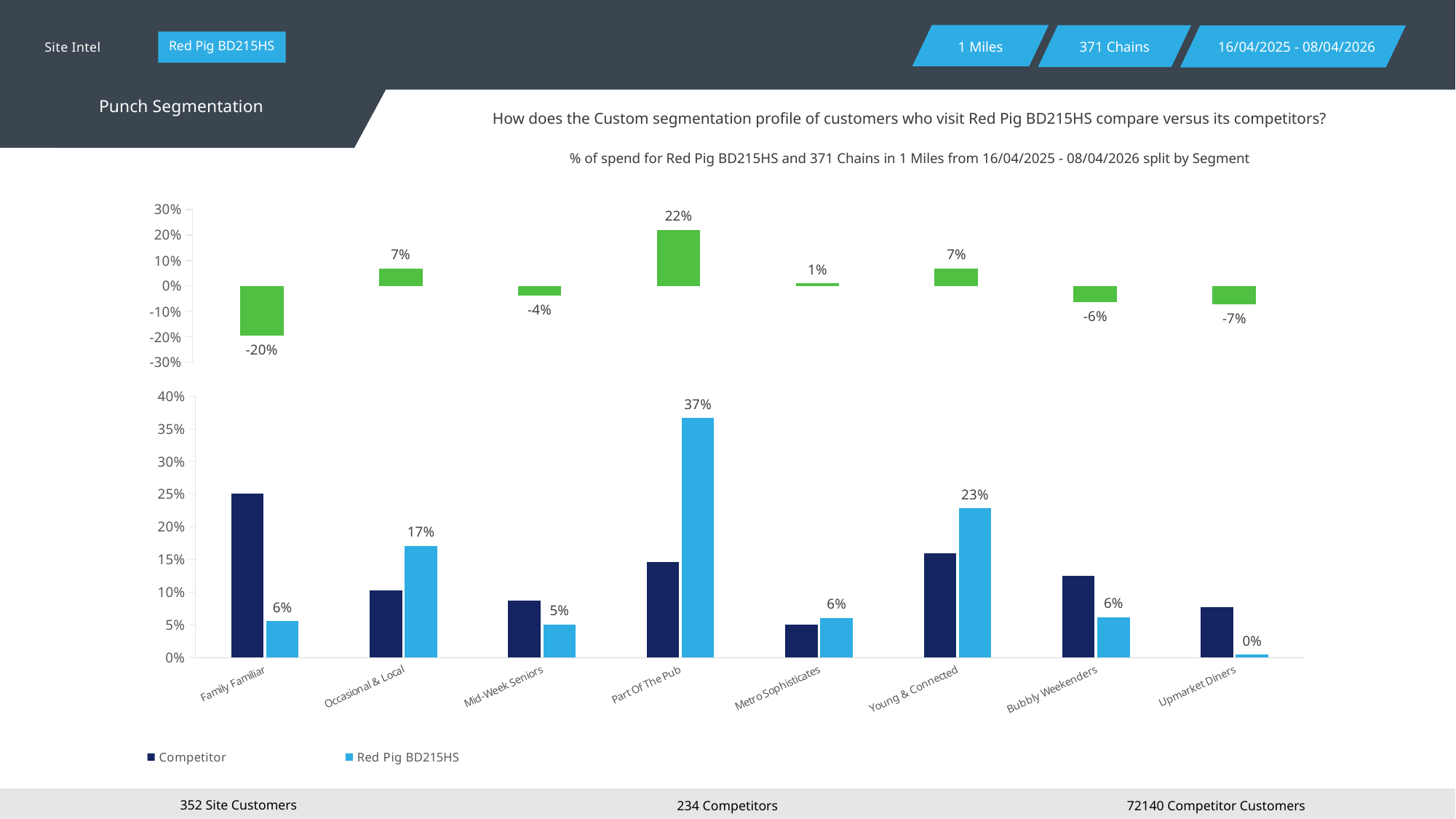
In the bottom chart, is the Competitor value for Family Familiar greater or less than 20%? greater In the bottom chart, what is the difference between the Red Pig BD215HS values for Part Of The Pub and Young & Connected? 14 percentage points How many segments are shown on the x axis of the bottom chart? 8 In the top chart, what is the value shown for Upmarket Diners? -7% In the top chart, which segment has the highest value? Part Of The Pub In the top chart, which segment has the lowest value? Family Familiar In the top chart, what is the value shown for Part Of The Pub? 22% In the bottom chart, what is the Red Pig BD215HS value for Young & Connected? 23% In the bottom chart, which segment has the highest Red Pig BD215HS value? Part Of The Pub In the bottom chart, what is the Red Pig BD215HS value for Upmarket Diners? 0% In the bottom chart, which is larger for Family Familiar: the Competitor value or the Red Pig BD215HS value? Competitor How many series does the legend of the bottom chart list? 2